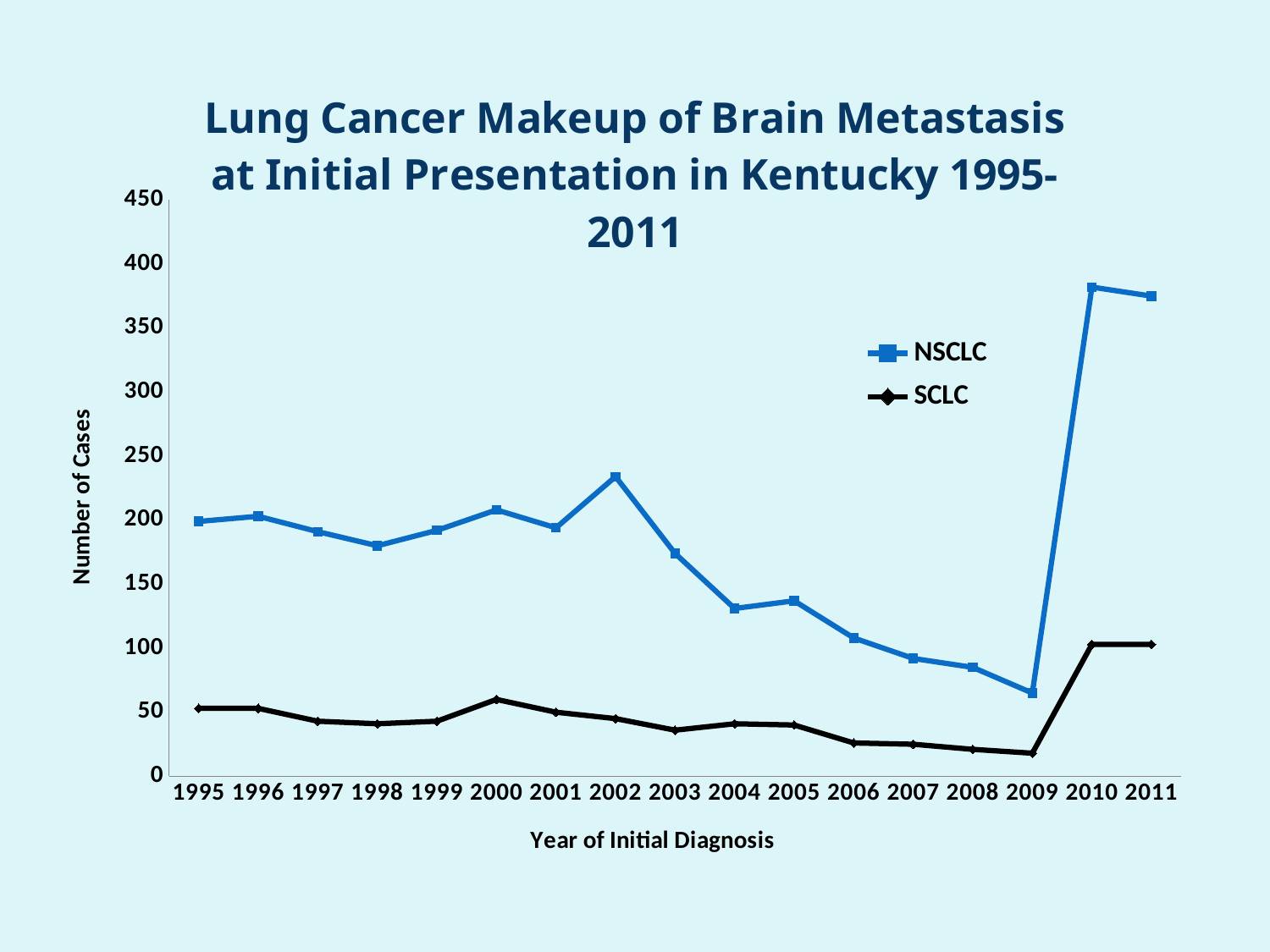
Is the NSCLC value for 2002 greater or less than 200? greater In which year is the NSCLC value highest? 2010 How many series does the legend list? 2 Which is larger, the NSCLC value for 2002 or the NSCLC value for 2003? 2002 Does the NSCLC line rise or fall from 2002 to 2009? Falls How many years are plotted along the x axis? 17 In which year is the NSCLC value lowest? 2009 In which year is the SCLC value lowest? 2009 What is the title of the x axis? Year of Initial Diagnosis Is the SCLC value for 2000 greater or less than 50? greater What kind of chart is shown on the slide? Line chart Is the NSCLC value for 2009 greater or less than 100? less